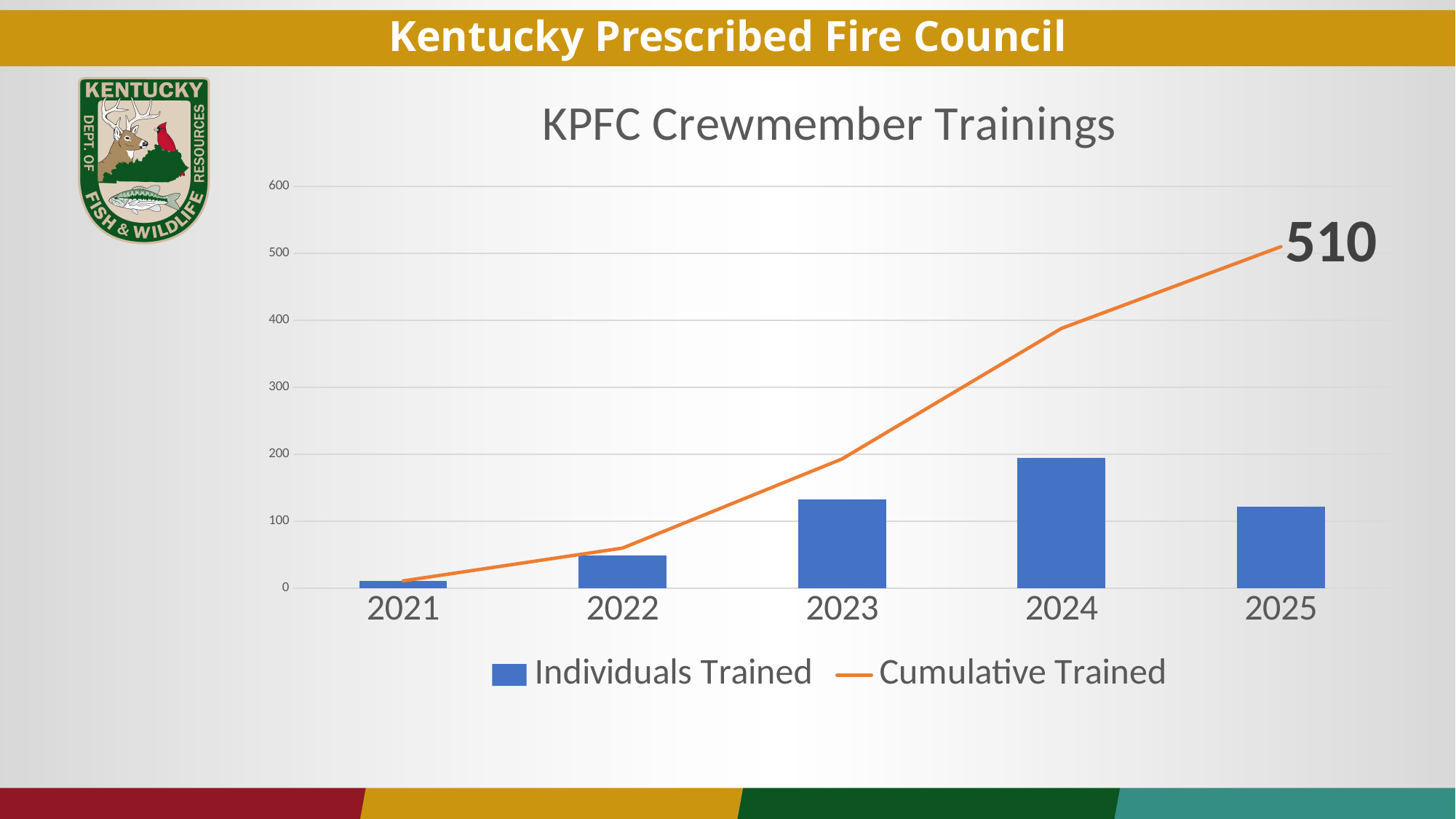
Which is larger, the Individuals Trained value for 2024 or for 2022? 2024 Is the Cumulative Trained value for 2024 greater or less than 300? greater Which year has the lowest Individuals Trained bar? 2021 How many years are shown on the x axis? 5 Does the Cumulative Trained line rise or fall from 2021 to 2025? Rises What kind of chart is this? Combined bar and line chart Is the Individuals Trained value for 2024 greater or less than 100? greater What is the Cumulative Trained value for 2025? 510 How many series does the legend list? 2 Is the Individuals Trained value for 2022 greater or less than 100? less Which year has the highest Individuals Trained bar? 2024 What is the title of the chart? KPFC Crewmember Trainings